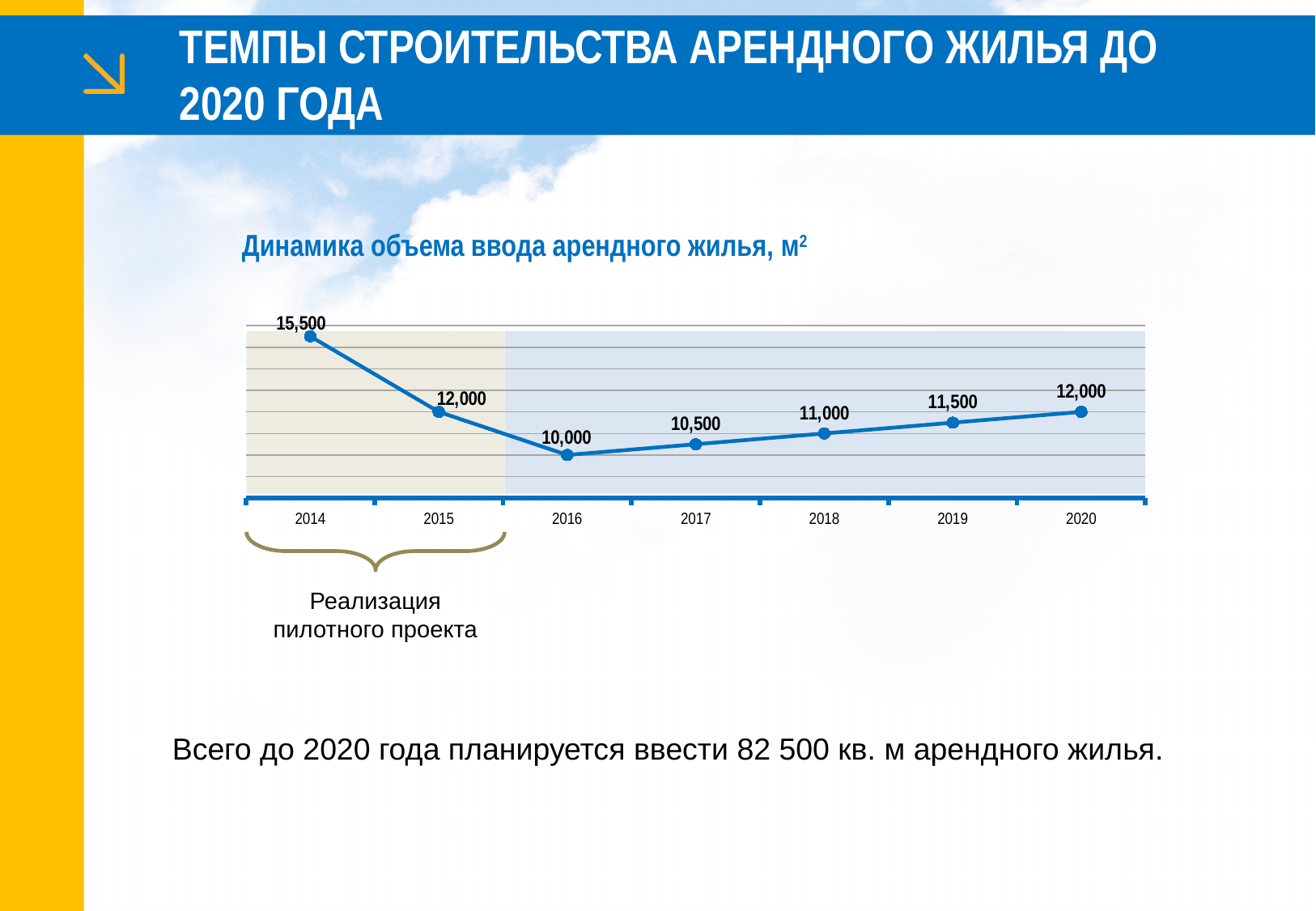
What kind of chart is shown? line chart What is the value for 2014? 15,500 Which year has the lowest value? 2016 What is the value for 2016? 10,000 What is the value for 2019? 11,500 Do the values rise or fall from 2016 to 2020? rise How many years are plotted on the chart? 7 What is the difference between the values for 2020 and 2017? 1,500 Which year has the highest value? 2014 What is the title of the chart? Динамика объема ввода арендного жилья, м² Which is larger, the value for 2015 or the value for 2018? 2015 What is the difference between the values for 2014 and 2016? 5,500